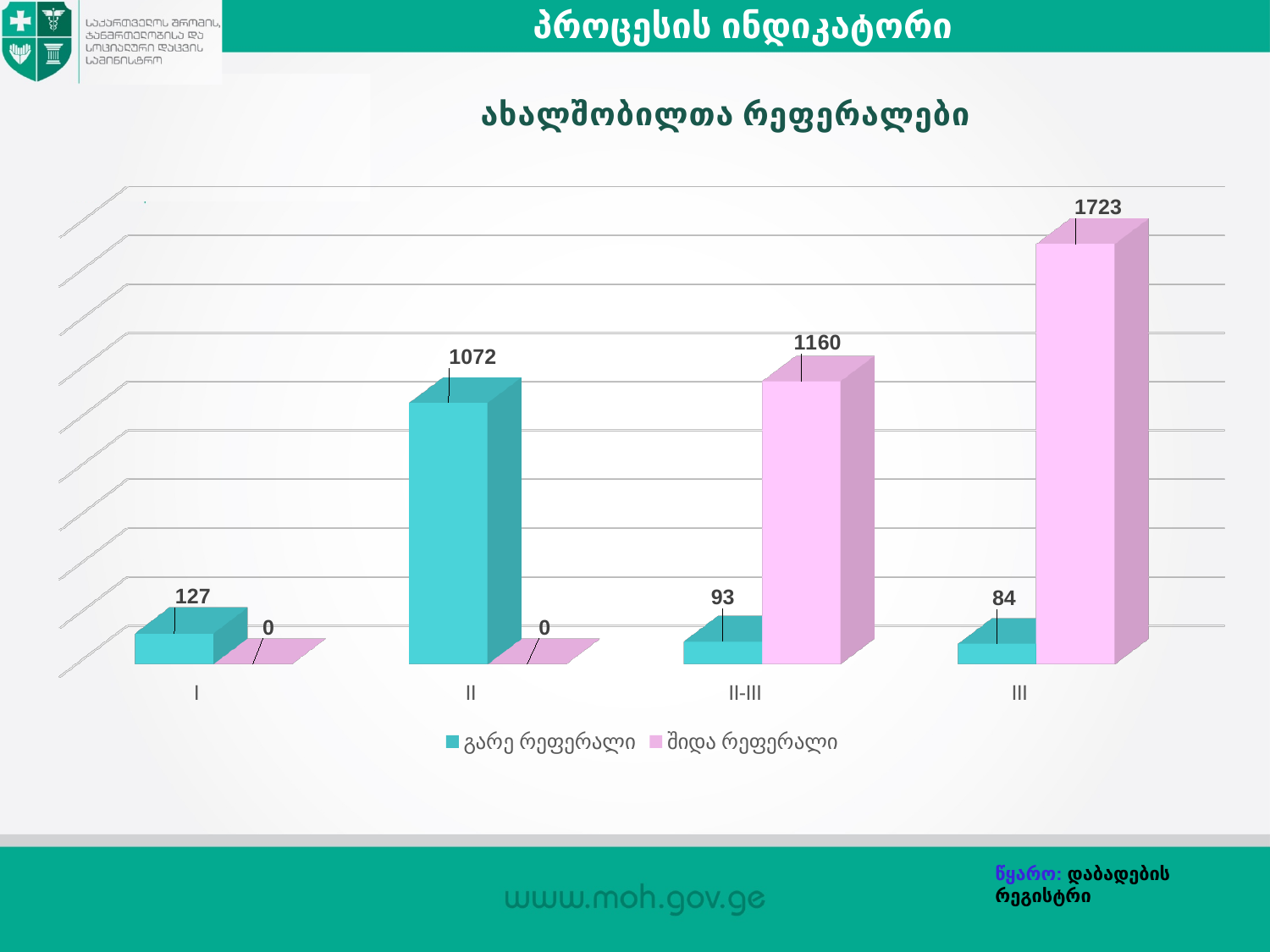
How many series does the legend list? 2 Which category has the highest value for შიდა რეფერალი? III What is the value of გარე რეფერალი for category II? 1072 What is the title of the chart? ახალშობილთა რეფერალები What is the value of შიდა რეფერალი for category III? 1723 What is the value of შიდა რეფერალი for category I? 0 What is the value of გარე რეფერალი for category II-III? 93 What is the difference between შიდა რეფერალი and გარე რეფერალი for category III? 1639 What kind of chart is shown on the slide? Bar chart Which category has the lowest value for გარე რეფერალი? III For category II-III, which series has the larger value, გარე რეფერალი or შიდა რეფერალი? შიდა რეფერალი How many categories are shown on the x axis? 4